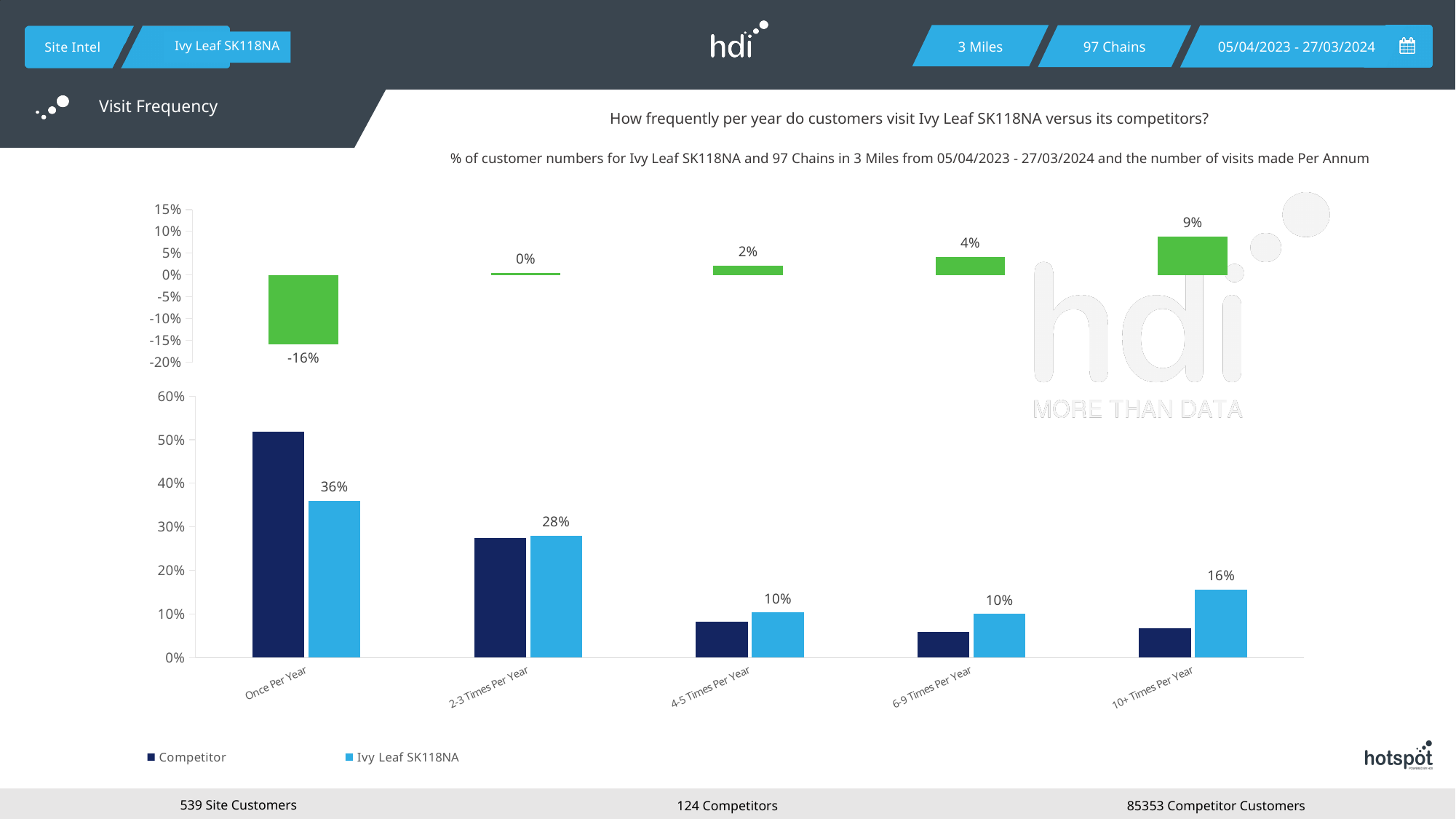
In the bottom bar chart, what is the Ivy Leaf SK118NA value for 10+ Times Per Year? 16% In the bottom bar chart, what is the difference between the Ivy Leaf SK118NA values for Once Per Year and 2-3 Times Per Year? 8% In the bottom bar chart, is the Competitor value for 6-9 Times Per Year greater or less than 10%? less In the top green chart, which category has the lowest value? Once Per Year In the top green chart, what is the value shown for Once Per Year? -16% How many visit frequency categories are shown on the x axis of the bottom bar chart? 5 In the bottom bar chart, is the Competitor value for Once Per Year greater or less than 50%? greater In the bottom bar chart, what is the Ivy Leaf SK118NA value for Once Per Year? 36% How many series does the legend of the bottom bar chart list? 2 In the bottom bar chart, for Once Per Year, which series has the larger value: Competitor or Ivy Leaf SK118NA? Competitor In the top green chart, what is the value shown for 10+ Times Per Year? 9% In the bottom bar chart, which visit frequency category has the highest Ivy Leaf SK118NA value? Once Per Year